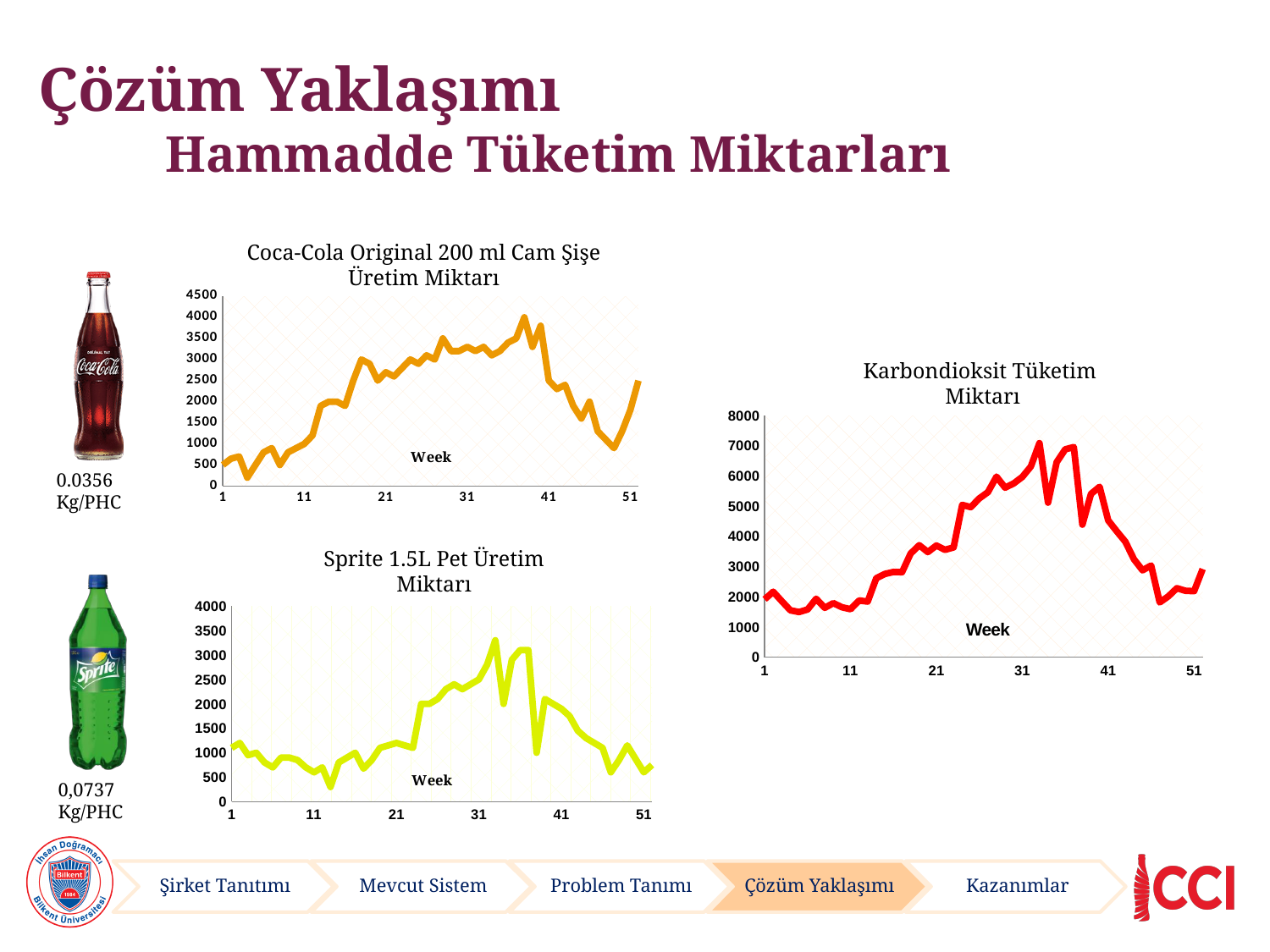
What is the x-axis label shown on the 'Sprite 1.5L Pet Üretim Miktarı' chart? Week In the 'Karbondioksit Tüketim Miktarı' chart, is the value at week 1 greater or less than 3000? less What is the highest tick value on the y-axis of the 'Karbondioksit Tüketim Miktarı' chart? 8000 What kind of chart is the 'Coca-Cola Original 200 ml Cam Şişe Üretim Miktarı' chart? line chart In the 'Sprite 1.5L Pet Üretim Miktarı' chart, is the highest value on the line greater or less than 3000? greater In the 'Coca-Cola Original 200 ml Cam Şişe Üretim Miktarı' chart, is the value at week 1 greater or less than 1000? less What kind of chart is the 'Karbondioksit Tüketim Miktarı' chart? line chart In the 'Karbondioksit Tüketim Miktarı' chart, do the values generally rise or fall from week 1 to week 31? rise In the 'Coca-Cola Original 200 ml Cam Şişe Üretim Miktarı' chart, do the values generally rise or fall from week 41 to week 49? fall